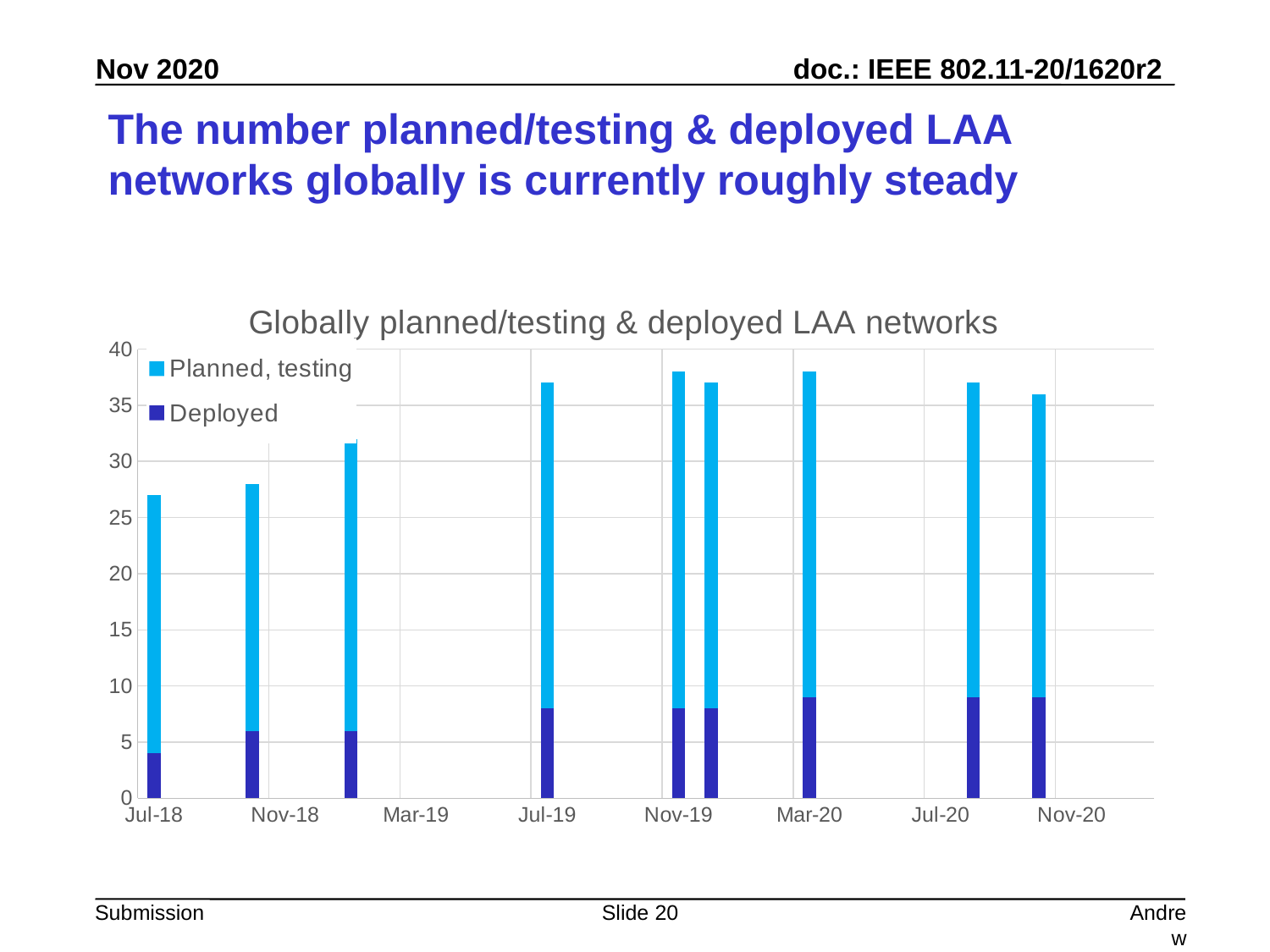
What kind of chart is shown on the slide? Stacked bar chart Is the Deployed value at Jul-18 greater or less than 5? less Which has a larger Deployed value, Jul-18 or Mar-20? Mar-20 Is the total height of the bar at Jul-18 greater or less than 30? less Do the total bar heights rise or fall from Jul-18 to Jul-19? rise How many stacked bars are plotted in the chart? 9 Which bar has a larger total, Jul-18 or Jul-19? Jul-19 Is the total height of the bar at Mar-20 greater or less than 35? greater What is the title of the chart? Globally planned/testing & deployed LAA networks What are the two series named in the chart legend? Planned, testing; Deployed How many series does the chart legend list? 2